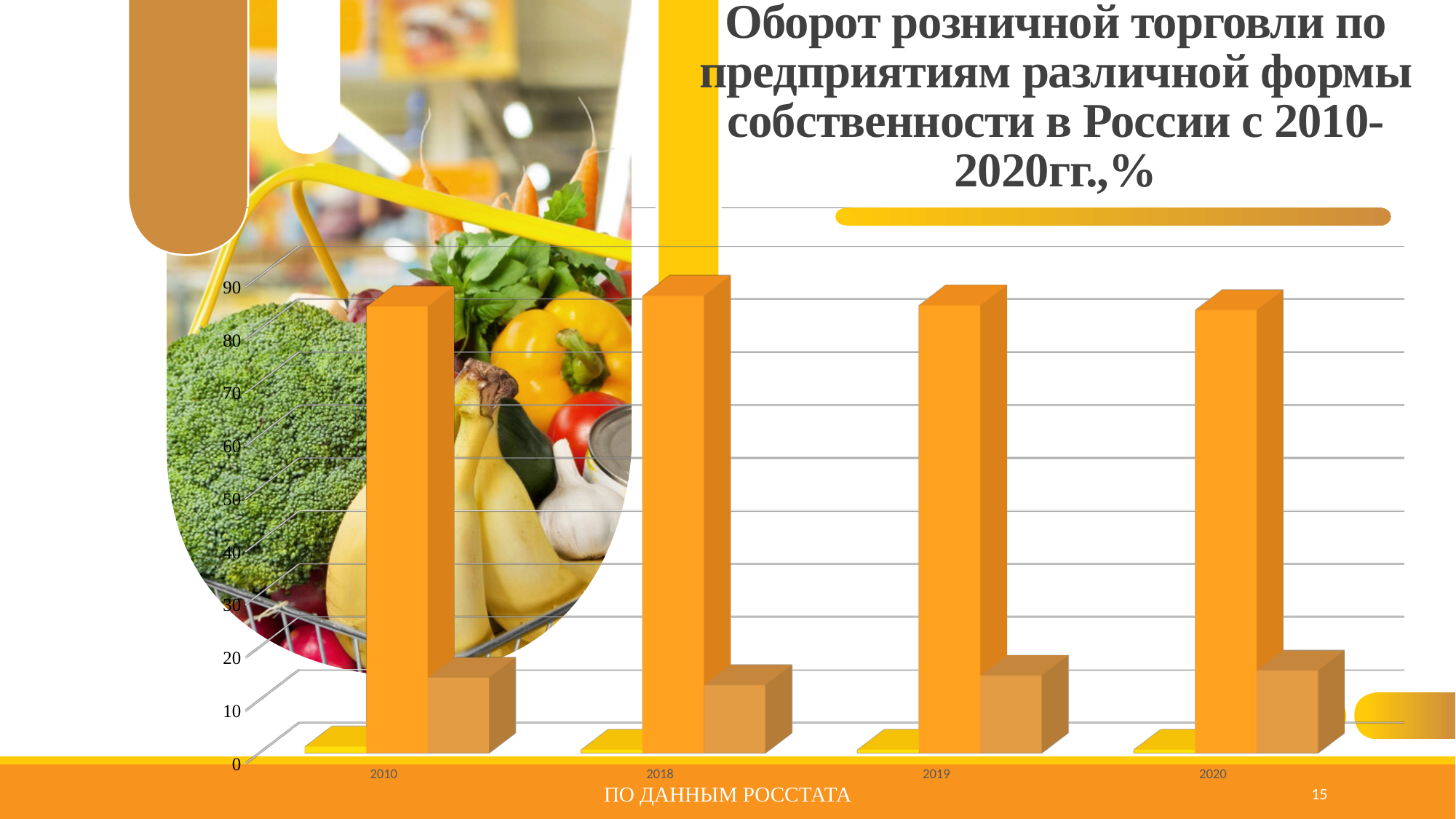
How many bars are plotted for each year on the chart? 2 For 2019, which bar is larger, the first (left) bar or the second (right) bar? the first (left) bar What kind of chart is shown on the slide? bar chart Is the value of the taller bar for 2018 greater or less than 80? greater Is the value of the taller bar for 2020 greater or less than 60? greater Which years are shown on the x axis of the chart? 2010, 2018, 2019, 2020 What is the title of the chart? Оборот розничной торговли по предприятиям различной формы собственности в России с 2010-2020гг.,% Is the value of the shorter bar for 2010 greater or less than 30? less How many years are shown on the x axis of the chart? 4 What is the highest value shown on the y axis of the chart? 90